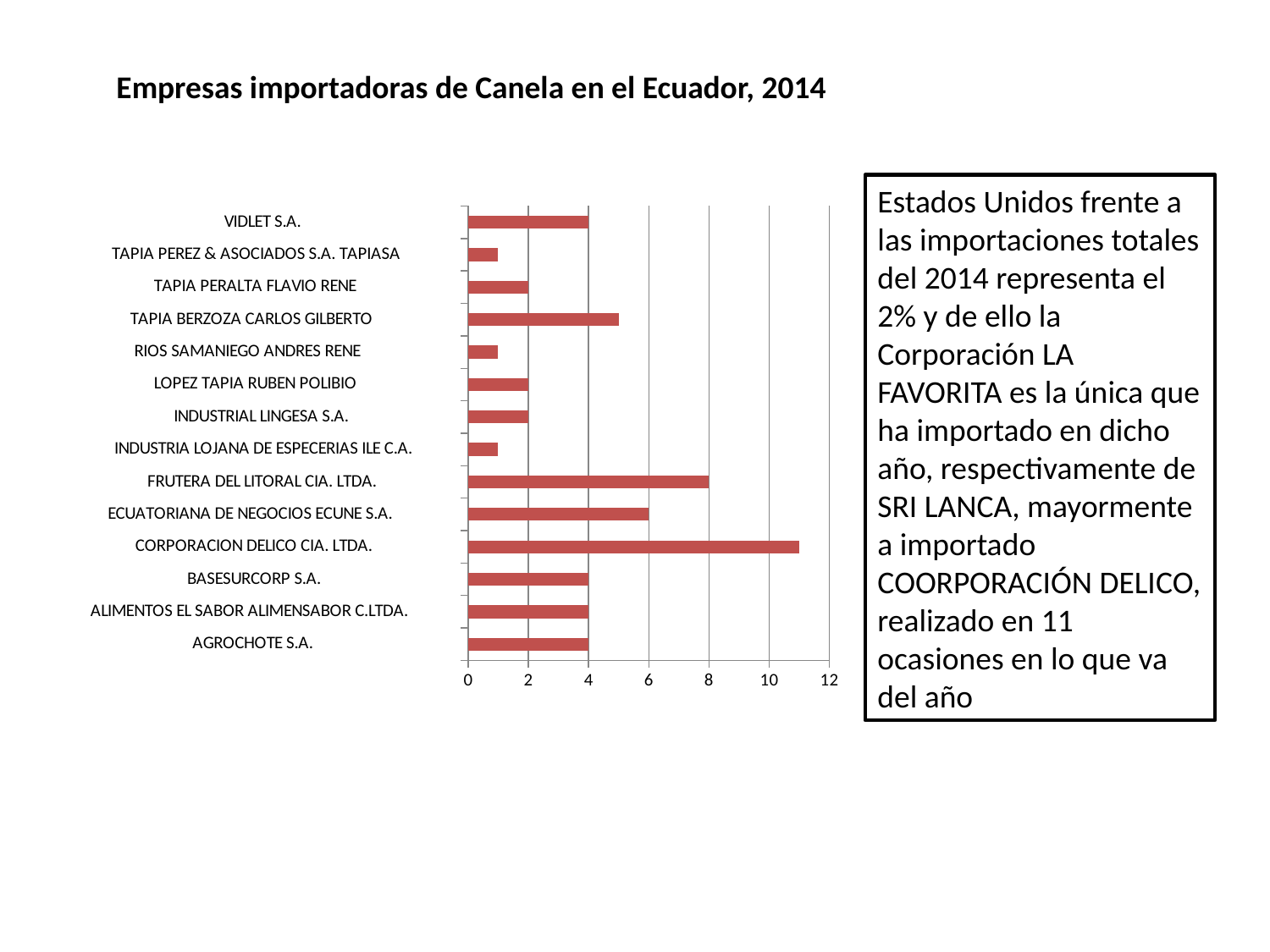
What is the value for VIDLET S.A.? 4 What is the value for INDUSTRIAL LINGESA S.A.? 2 What is the value for ECUATORIANA DE NEGOCIOS ECUNE S.A.? 6 What is the title of the slide's chart? Empresas importadoras de Canela en el Ecuador, 2014 What is the value for FRUTERA DEL LITORAL CIA. LTDA.? 8 Is the value for CORPORACION DELICO CIA. LTDA. greater or less than 10? greater What is the difference between the values for FRUTERA DEL LITORAL CIA. LTDA. and ECUATORIANA DE NEGOCIOS ECUNE S.A.? 2 What kind of chart is shown on the slide? Bar chart How many companies (categories) are plotted in the chart? 14 Which is larger, the value for FRUTERA DEL LITORAL CIA. LTDA. or the value for ECUATORIANA DE NEGOCIOS ECUNE S.A.? FRUTERA DEL LITORAL CIA. LTDA. Is the value for RIOS SAMANIEGO ANDRES RENE greater or less than 2? less Which company has the highest value in the chart? CORPORACION DELICO CIA. LTDA.